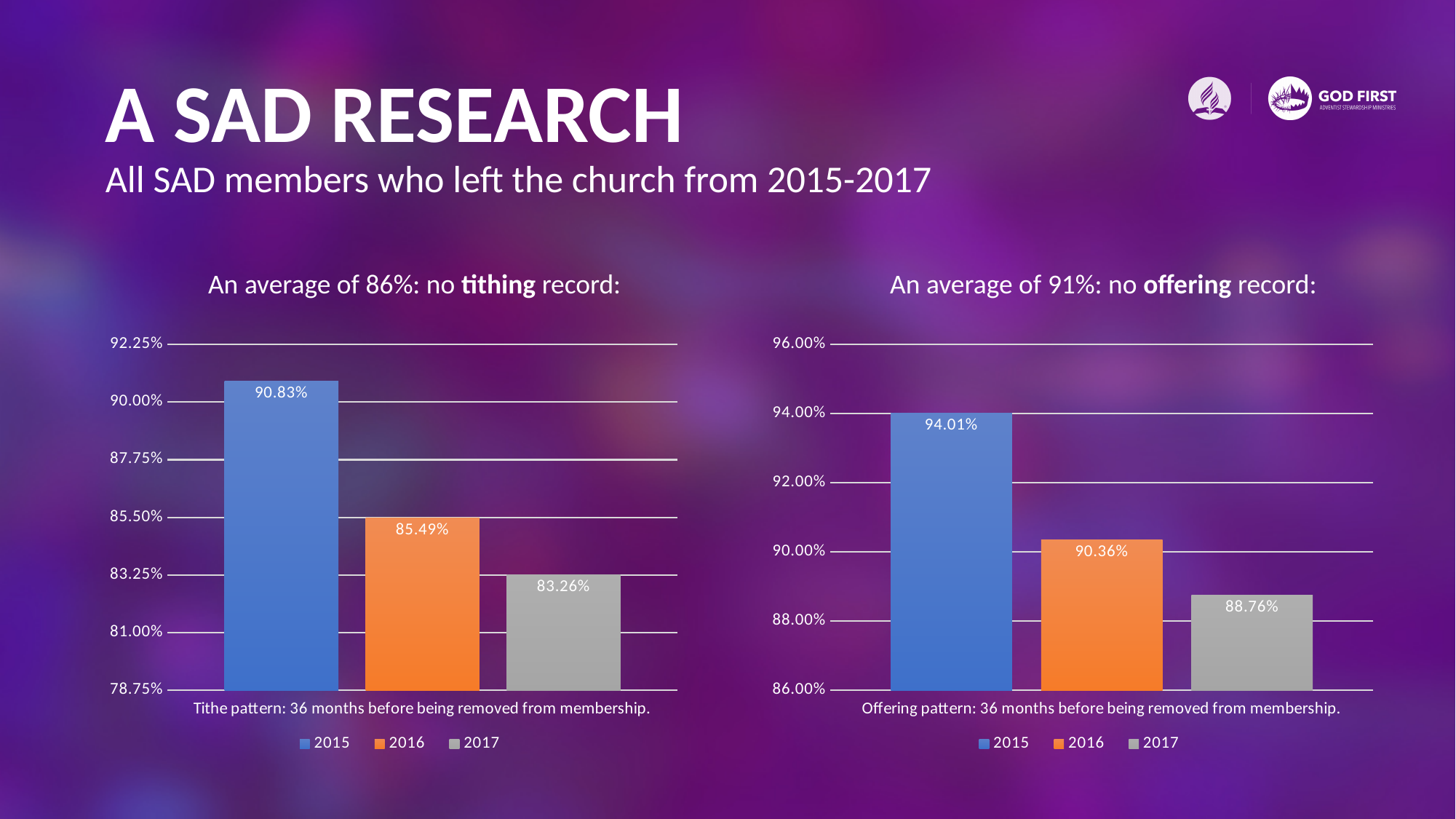
In the tithe pattern chart on the left, do the values rise or fall from 2015 to 2017? fall How many series does the legend of the tithe pattern chart on the left list? 3 In the offering pattern chart on the right, what is the value for 2016? 90.36% In the tithe pattern chart on the left, which is larger, the value for 2016 or the value for 2017? 2016 In the tithe pattern chart on the left, what is the difference between the 2015 and 2016 values? 5.34% What kind of chart is the offering pattern chart on the right? bar chart In the offering pattern chart on the right, is the value for 2016 greater or less than 90.00%? greater In the offering pattern chart on the right, what is the value for 2017? 88.76% In the tithe pattern chart on the left, what is the value for 2015? 90.83% In the offering pattern chart on the right, what is the difference between the 2015 and 2017 values? 5.25% In the offering pattern chart on the right, which year has the highest value? 2015 In the tithe pattern chart on the left, which year has the lowest value? 2017